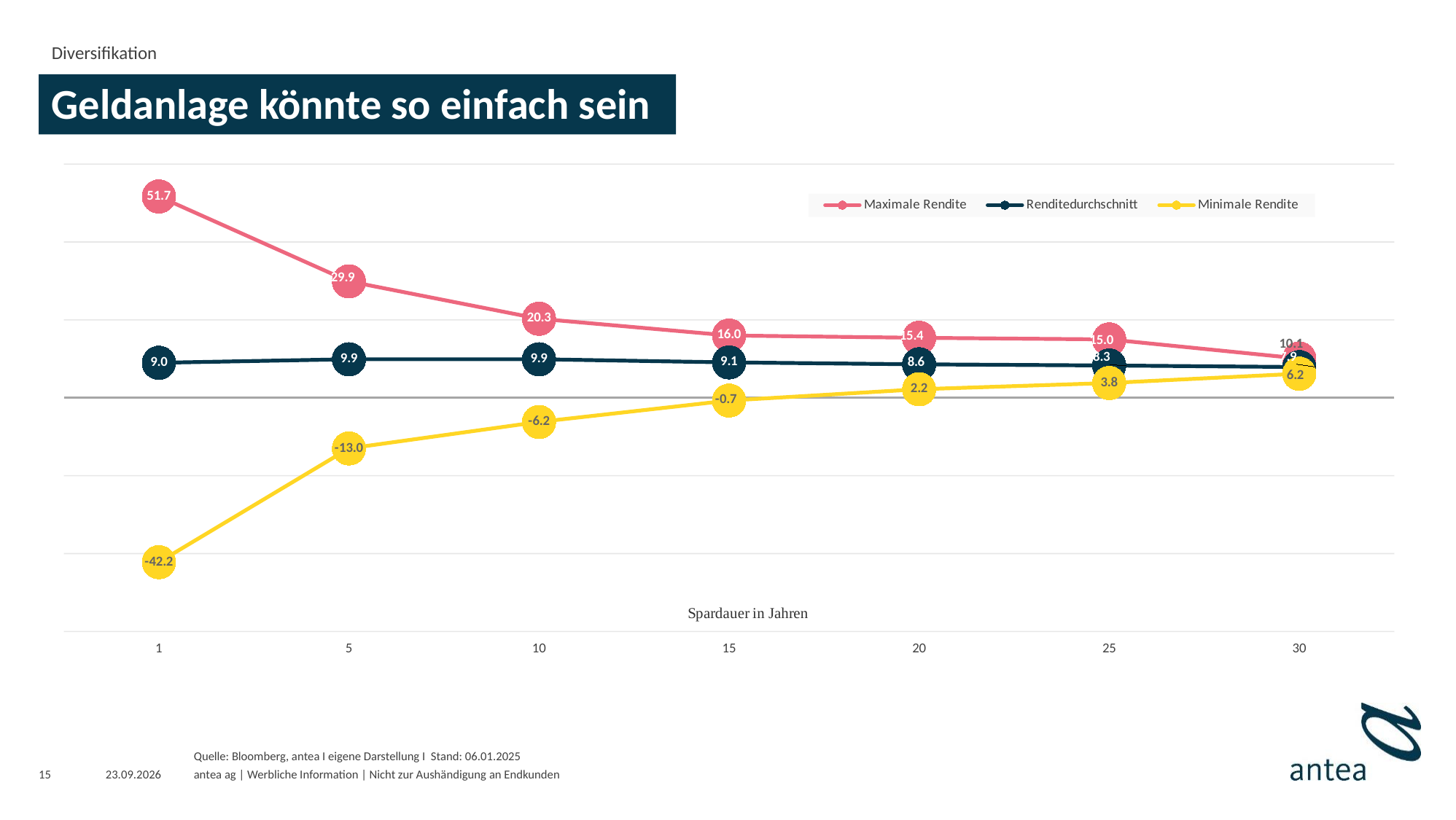
At which Spardauer is Minimale Rendite lowest? 1 What is the value of Minimale Rendite at a Spardauer of 10 years? -6.2 How many points on the x axis (Spardauer in Jahren) are plotted for each series? 7 At which Spardauer is Maximale Rendite highest? 1 What is the value of Renditedurchschnitt at a Spardauer of 5 years? 9.9 Does Maximale Rendite rise or fall as the Spardauer increases? fall What is the difference between Maximale Rendite and Minimale Rendite at a Spardauer of 1 year? 93.9 What is the value of Maximale Rendite at a Spardauer of 1 year? 51.7 Which is larger: Minimale Rendite at 20 years or at 25 years? 25 years What is the value of Minimale Rendite at a Spardauer of 1 year? -42.2 How many series does the legend list? 3 What kind of chart is shown on the slide? line chart